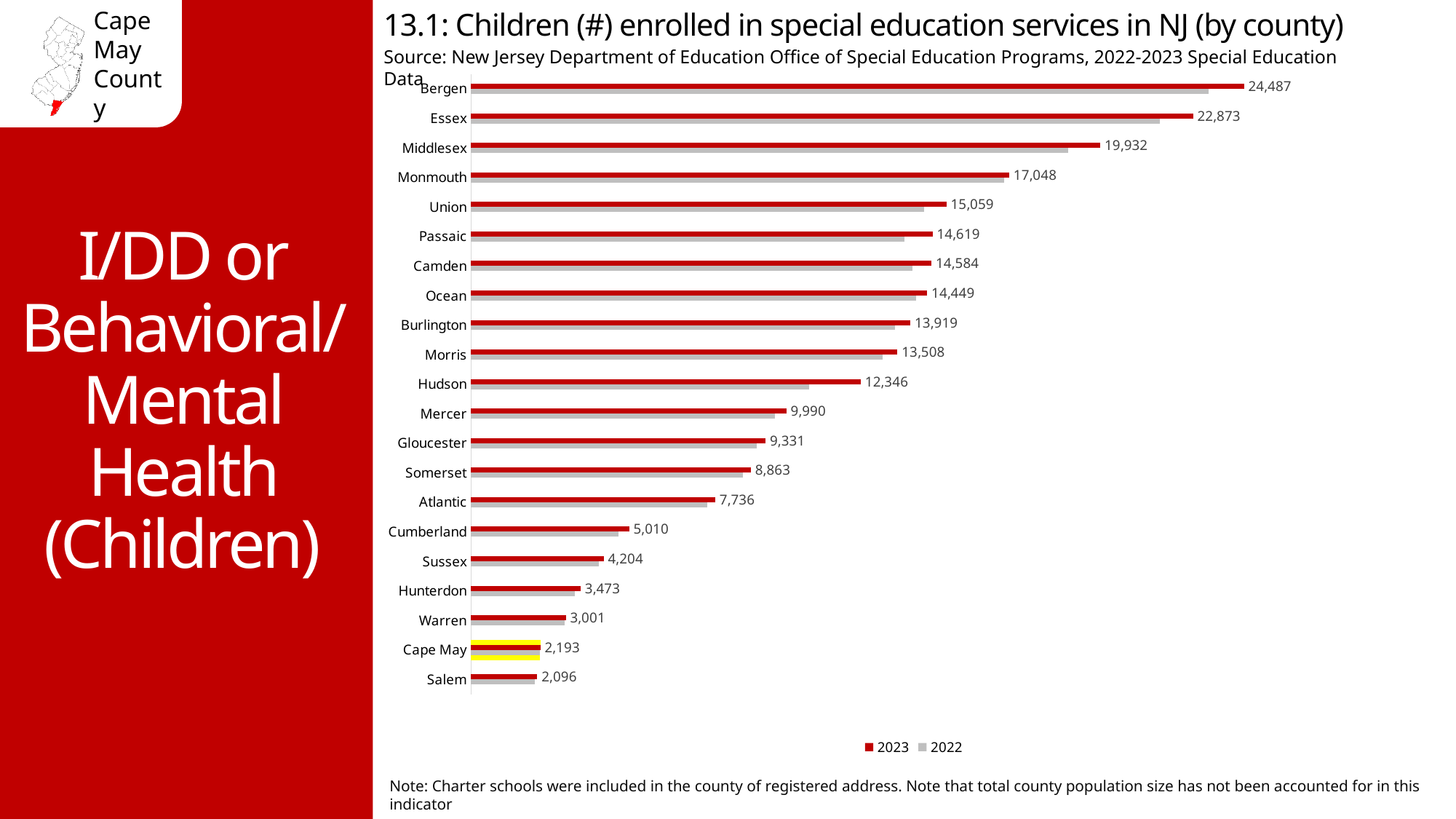
What is the difference between the 2023 values for Cape May and Salem? 97 What kind of chart is shown on the slide? bar chart How many series does the legend list? 2 Which county has the lowest 2023 value? Salem Which county has the highest 2023 value? Bergen What is the 2023 value for Monmouth? 17,048 Which series is shown in red in the legend? 2023 What is the 2023 value for Cape May? 2,193 Which has a larger 2023 value, Hudson or Mercer? Hudson What is the 2023 value for Cumberland? 5,010 How many counties are shown in the chart? 21 What is the difference between the 2023 values for Bergen and Essex? 1,614